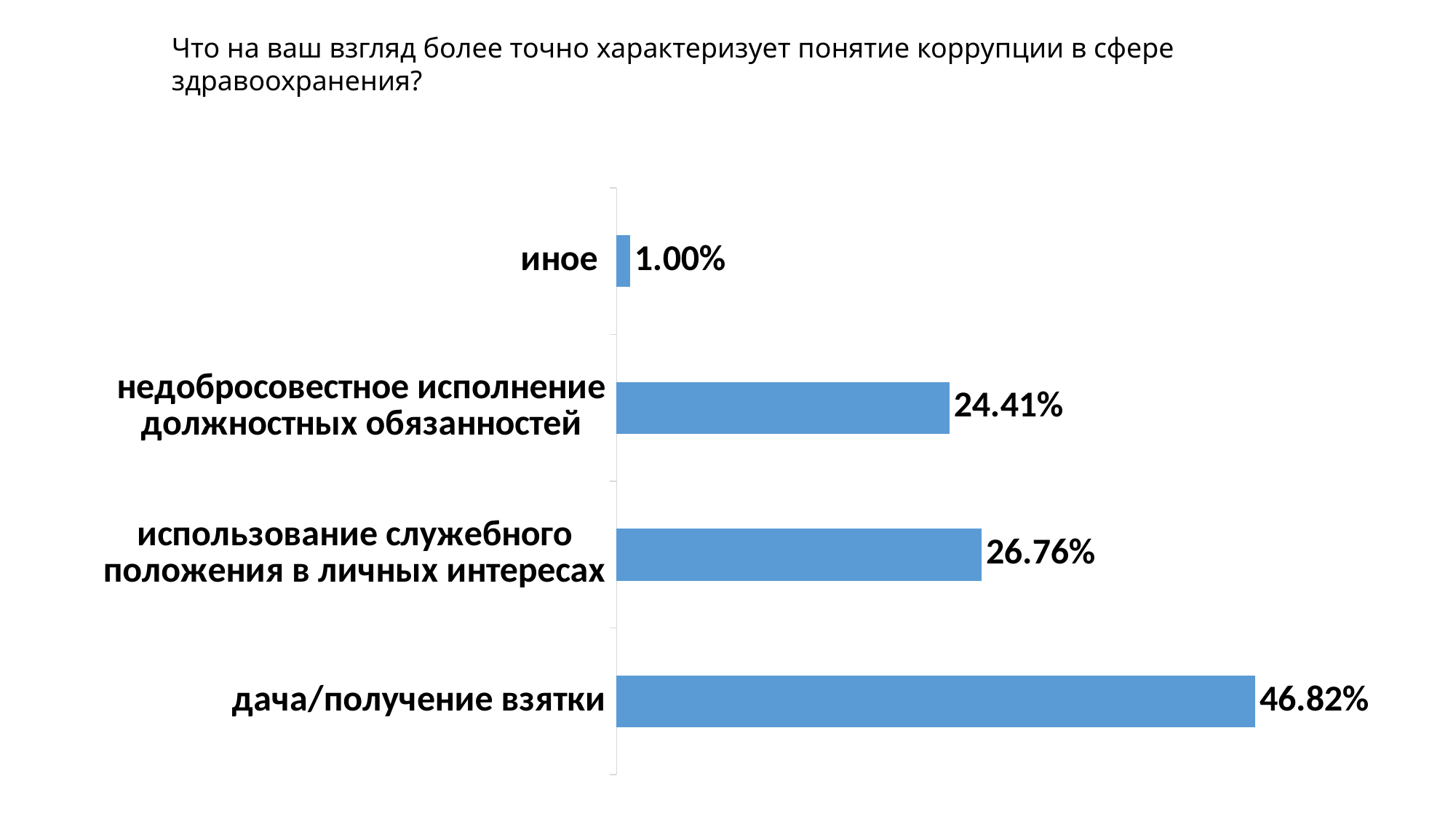
What is the difference between the values for "использование служебного положения в личных интересах" and "недобросовестное исполнение должностных обязанностей"? 2.35% What kind of chart is shown on the slide? bar chart Which category has the highest value? дача/получение взятки Which is larger: the value for "дача/получение взятки" or the value for "недобросовестное исполнение должностных обязанностей"? дача/получение взятки What colour are the bars in the chart? blue What is the difference between the values for "дача/получение взятки" and "использование служебного положения в личных интересах"? 20.06% What is the value for "иное"? 1.00% What is the value for "дача/получение взятки"? 46.82% What is the value for "использование служебного положения в личных интересах"? 26.76% Which category has the lowest value? иное How many categories are shown in the chart? 4 What is the value for "недобросовестное исполнение должностных обязанностей"? 24.41%